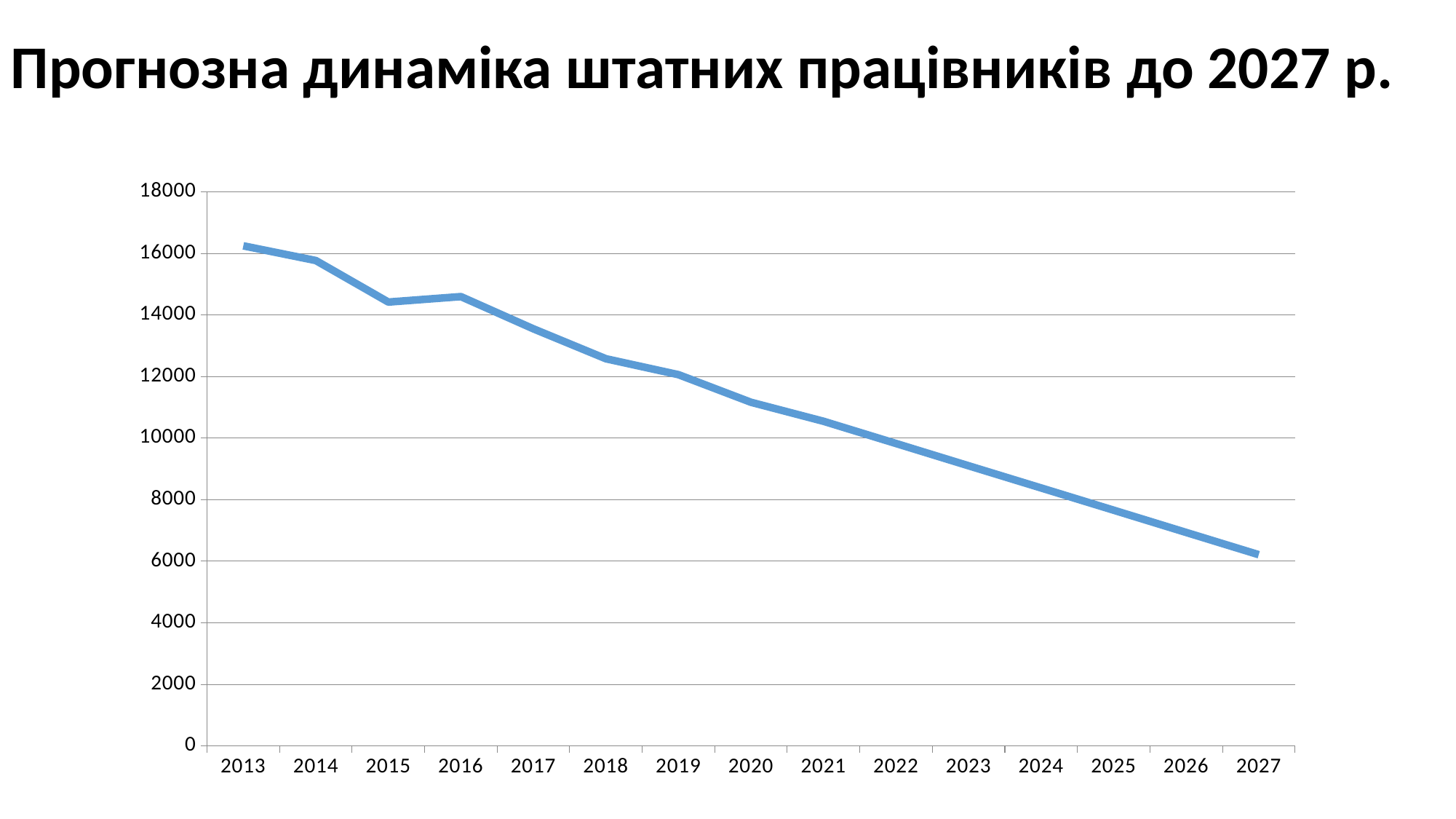
Which year has the larger value, 2014 or 2020? 2014 Is the value for 2027 greater or less than 8000? less Which year has the larger value, 2022 or 2017? 2017 Do the values generally rise or fall from 2013 to 2027? fall Which year has the highest value? 2013 What kind of chart is shown on the slide? line chart What is the title of the slide? Прогнозна динаміка штатних працівників до 2027 р. Is the value for 2013 greater or less than 16000? greater How many years are plotted along the x axis? 15 Is the value for 2024 greater or less than 10000? less Which year has the lowest value? 2027